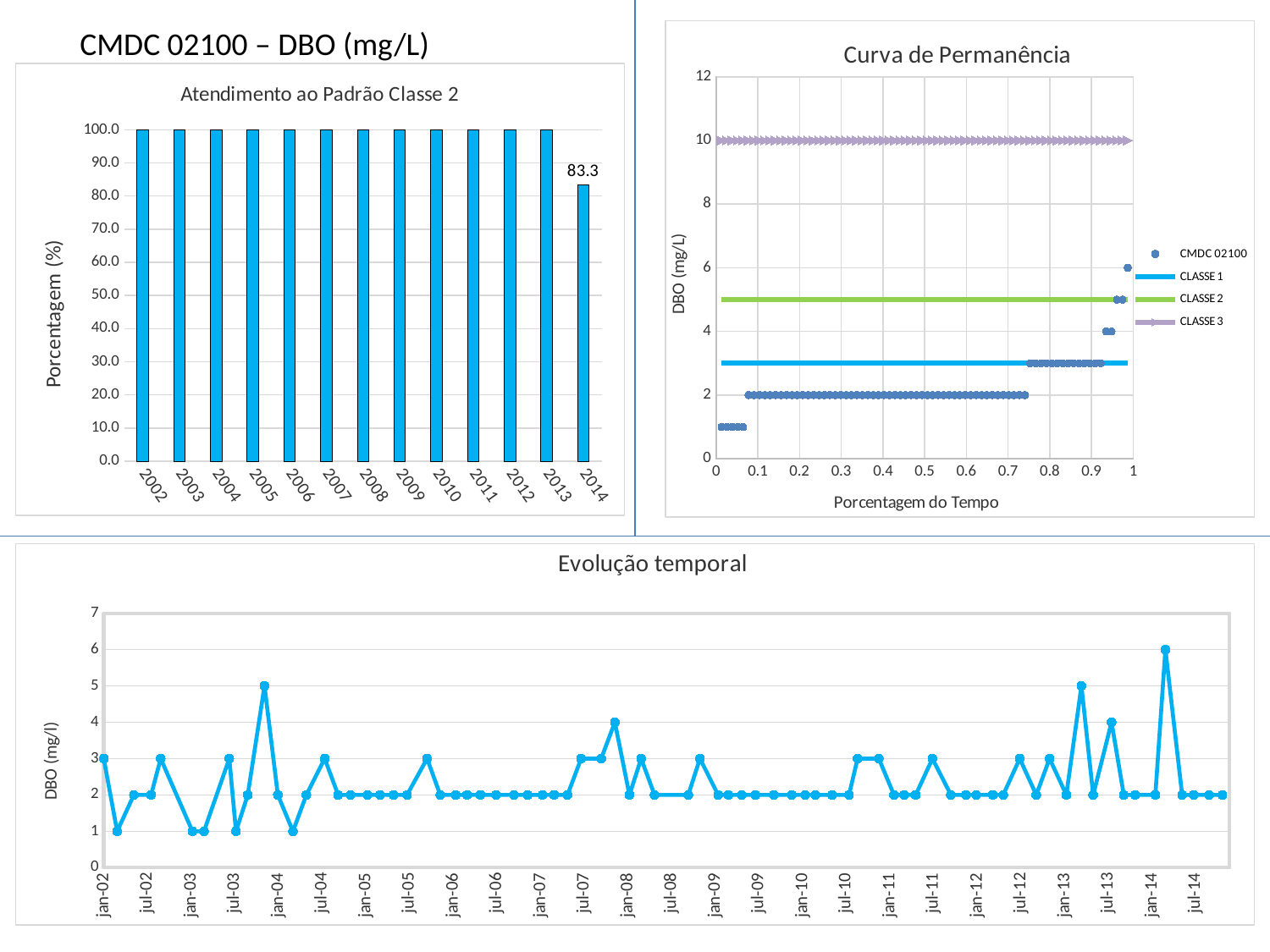
What is the title of the chart at the bottom of the slide? Evolução temporal In the 'Curva de Permanência' chart, how many series does the legend list? 4 In the 'Curva de Permanência' chart, what DBO value does the CLASSE 3 line sit at? 10 In the 'Atendimento ao Padrão Classe 2' chart, what is the difference between the values for 2013 and 2014? 16.7 In the 'Curva de Permanência' chart, which is higher, the CLASSE 1 line or the CLASSE 2 line? CLASSE 2 In the 'Atendimento ao Padrão Classe 2' chart, what is the value for 2014? 83.3 In the 'Atendimento ao Padrão Classe 2' chart, which year has the lowest value? 2014 In the 'Evolução temporal' chart, what is the highest DBO value reached? 6 In the 'Atendimento ao Padrão Classe 2' chart, how many years are shown on the x axis? 13 In the 'Curva de Permanência' chart, is the CLASSE 2 line greater or less than 4 mg/L? greater What kind of chart is 'Atendimento ao Padrão Classe 2'? bar chart In the 'Atendimento ao Padrão Classe 2' chart, what is the value for 2008? 100.0